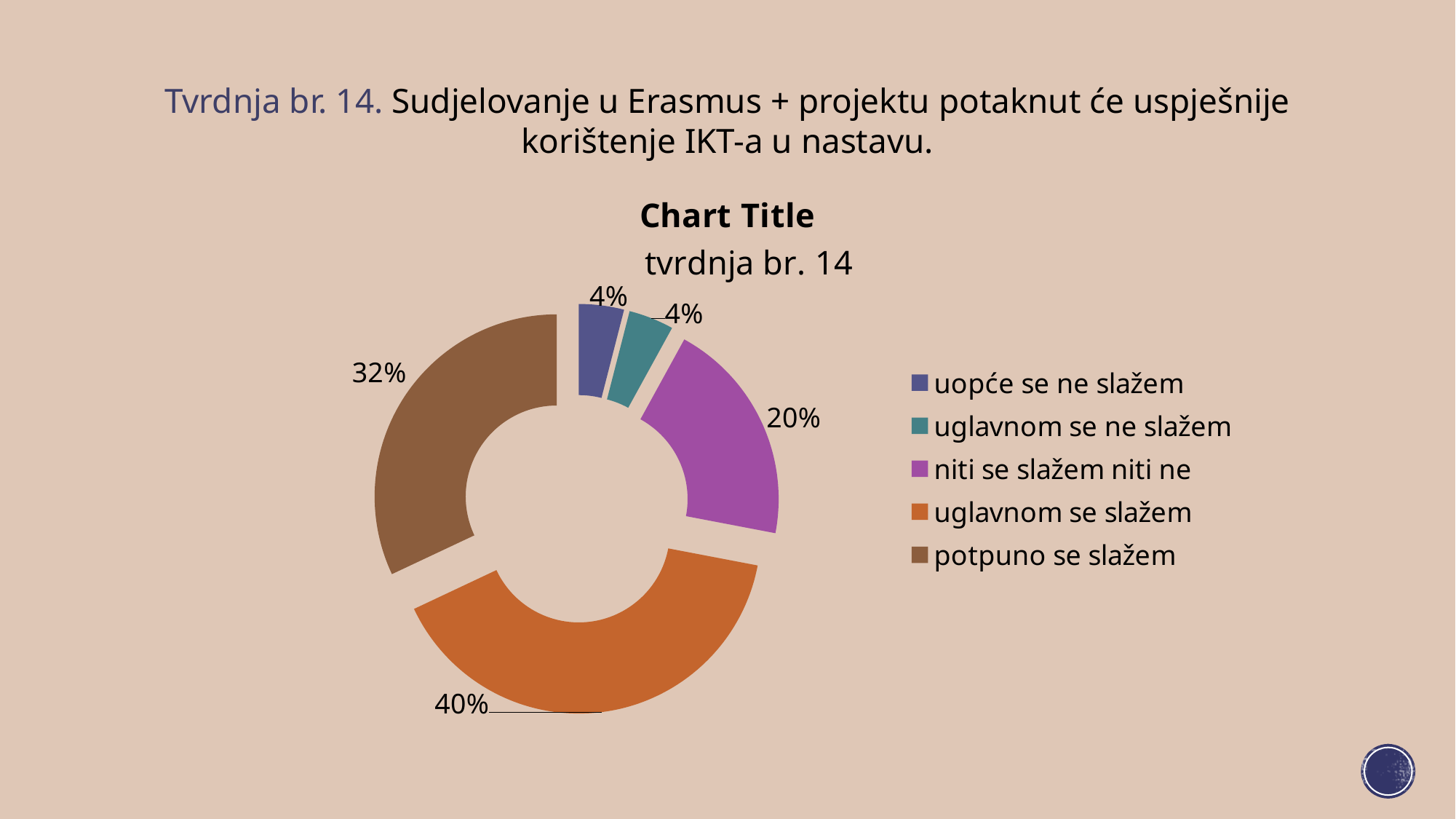
What is the combined share of "uglavnom se slažem" and "potpuno se slažem"? 72% Which is larger: the share for "niti se slažem niti ne" or the share for "potpuno se slažem"? potpuno se slažem What is the series name shown below the chart title? tvrdnja br. 14 How many response categories does the legend list? 5 Which response category has the largest share? uglavnom se slažem What percentage of respondents answered "uglavnom se slažem"? 40% What is the difference in percentage points between "uglavnom se slažem" and "potpuno se slažem"? 8 What percentage of respondents answered "uopće se ne slažem"? 4% What percentage of respondents answered "potpuno se slažem"? 32% Which colour represents "niti se slažem niti ne" in the chart? purple What kind of chart is shown on the slide? doughnut chart What percentage of respondents answered "niti se slažem niti ne"? 20%